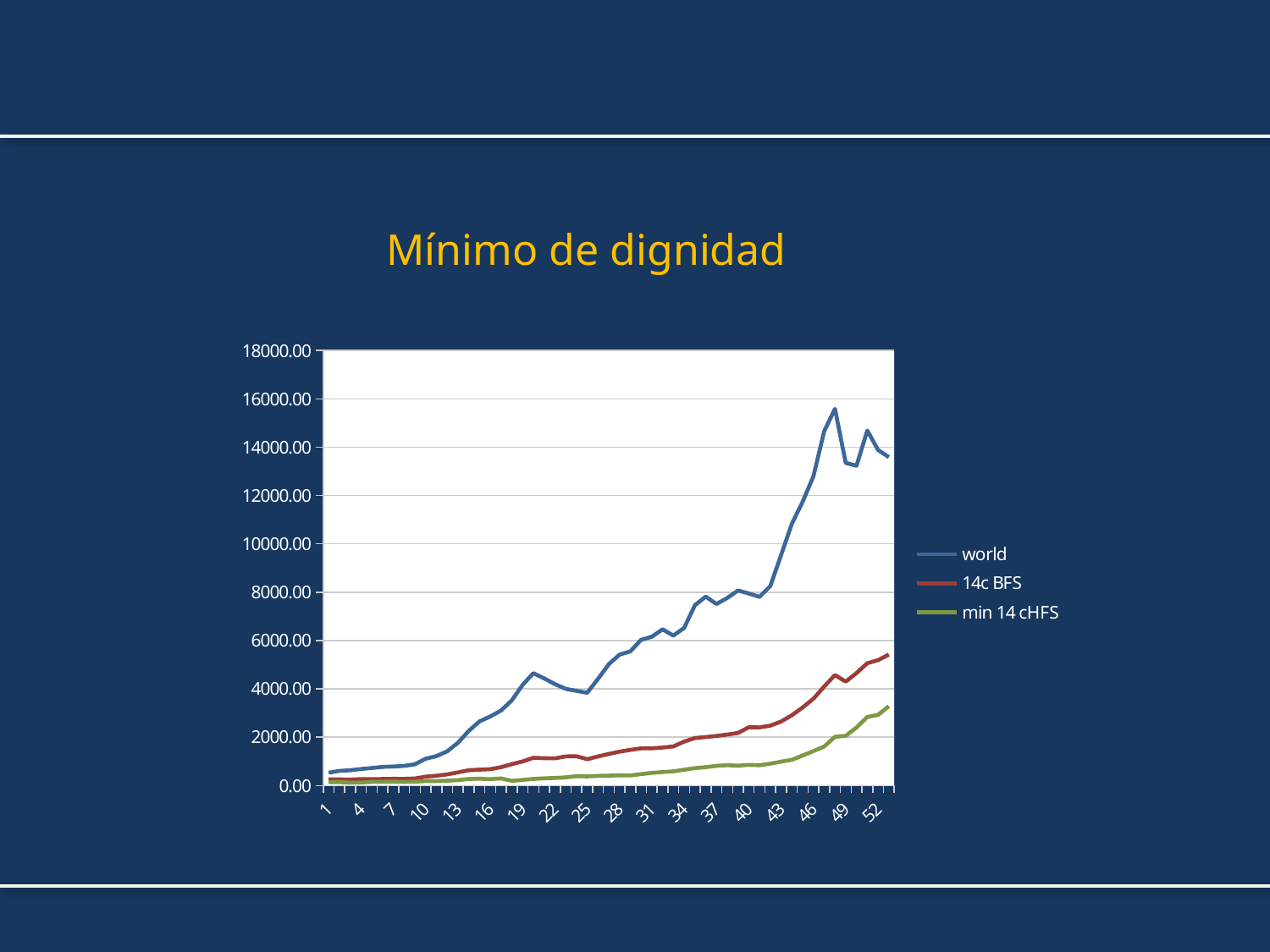
How many series does the legend list? 3 Is the value of the min 14 cHFS series at x = 52 greater or less than 2000.00? greater Which series is plotted with the green line? min 14 cHFS What kind of chart is shown on the slide? line chart Which series has the lowest values across the chart? min 14 cHFS At x = 52, which series has the larger value, 14c BFS or min 14 cHFS? 14c BFS Is the value of the world series at x = 28 greater or less than 4000.00? greater Is the value of the 14c BFS series at x = 52 greater or less than 4000.00? greater Does the world series generally rise or fall from x = 1 to x = 52? rise Which series reaches the highest values on the chart? world What is the title of the chart? Mínimo de dignidad